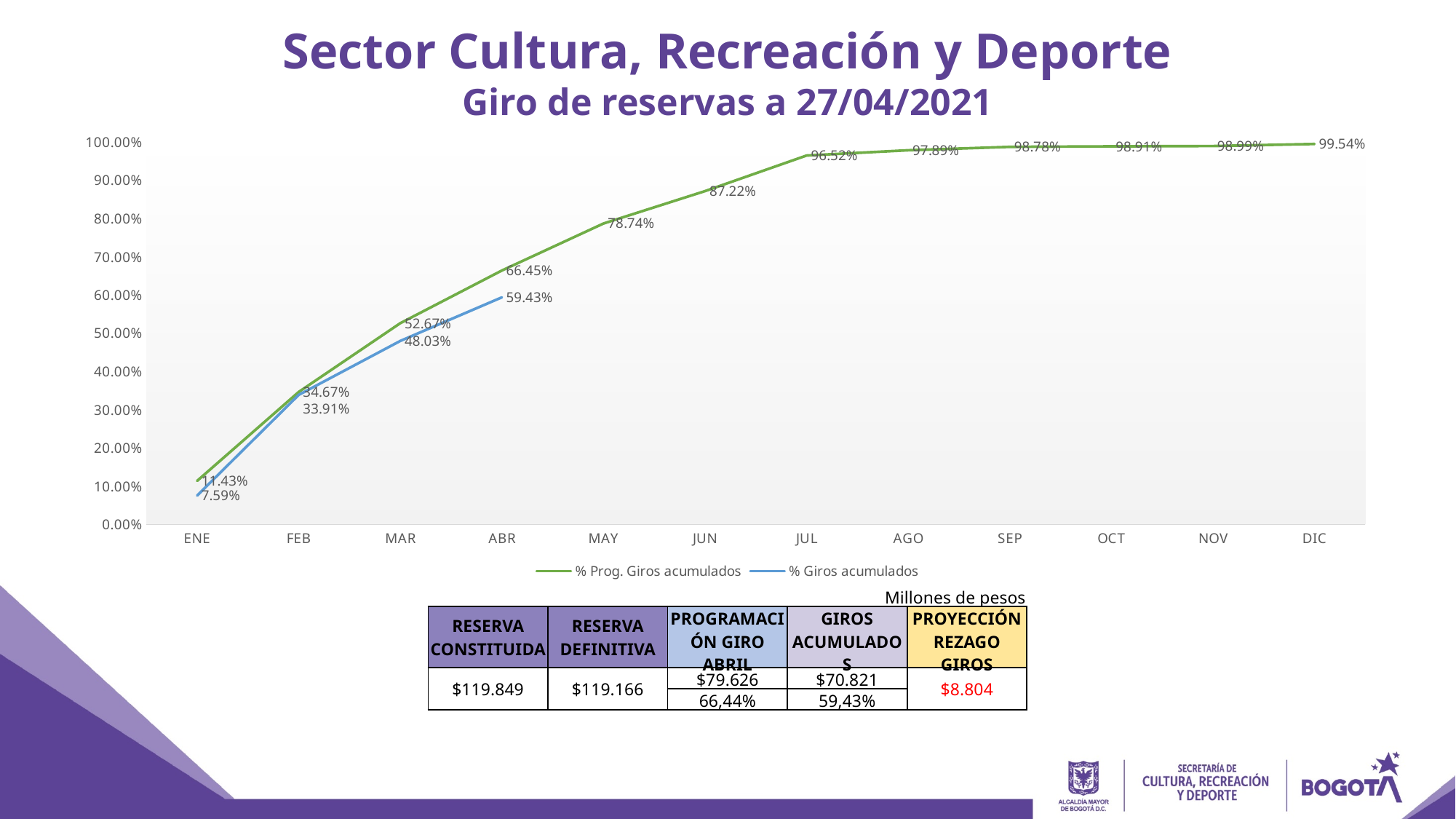
Does % Prog. Giros acumulados rise or fall from ENE to DIC? rise In which month is % Prog. Giros acumulados lowest? ENE How many months are shown on the x axis? 12 What is the value of % Giros acumulados for ENE? 7.59% What is the value of % Prog. Giros acumulados for DIC? 99.54% How many series does the chart legend list? 2 What is the value of % Giros acumulados for ABR? 59.43% What colour is the line for % Giros acumulados? blue What is the difference between % Prog. Giros acumulados and % Giros acumulados in ABR? 7.02% Which is larger in MAR: % Prog. Giros acumulados or % Giros acumulados? % Prog. Giros acumulados What is the value of % Prog. Giros acumulados for JUL? 96.52% What type of chart is shown on the slide? line chart